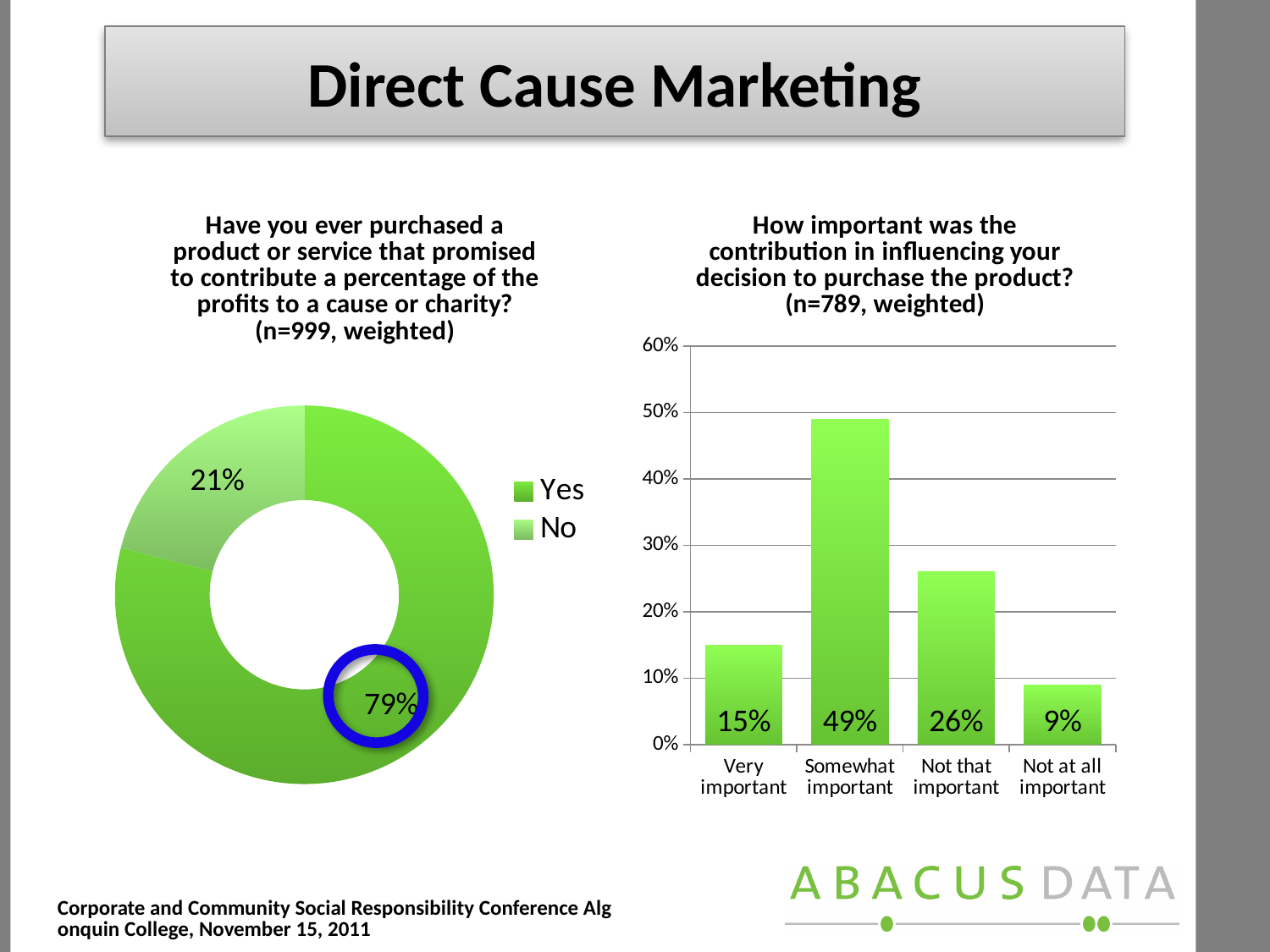
In the left chart, what is the difference between the Yes and No shares? 58% In the left chart (Have you ever purchased a product or service...), what percentage answered No? 21% In the right chart (How important was the contribution...), which category has the lowest value? Not at all important How many categories are shown in the right chart (How important was the contribution...)? 4 In the right chart (How important was the contribution...), which category has the highest value? Somewhat important How many entries does the legend of the left chart list? 2 In the right chart (How important was the contribution...), what is the value for Not at all important? 9% What kind of chart is the left chart on the slide? Pie chart (doughnut) In the right chart (How important was the contribution in influencing your decision to purchase the product?), what is the value for Somewhat important? 49% In the right chart (How important was the contribution...), what is the difference between Somewhat important and Not that important? 23% In the right chart (How important was the contribution...), which is larger: Very important or Not that important? Not that important In the left chart (Have you ever purchased a product or service that promised to contribute a percentage of the profits to a cause or charity?), what percentage answered Yes? 79%